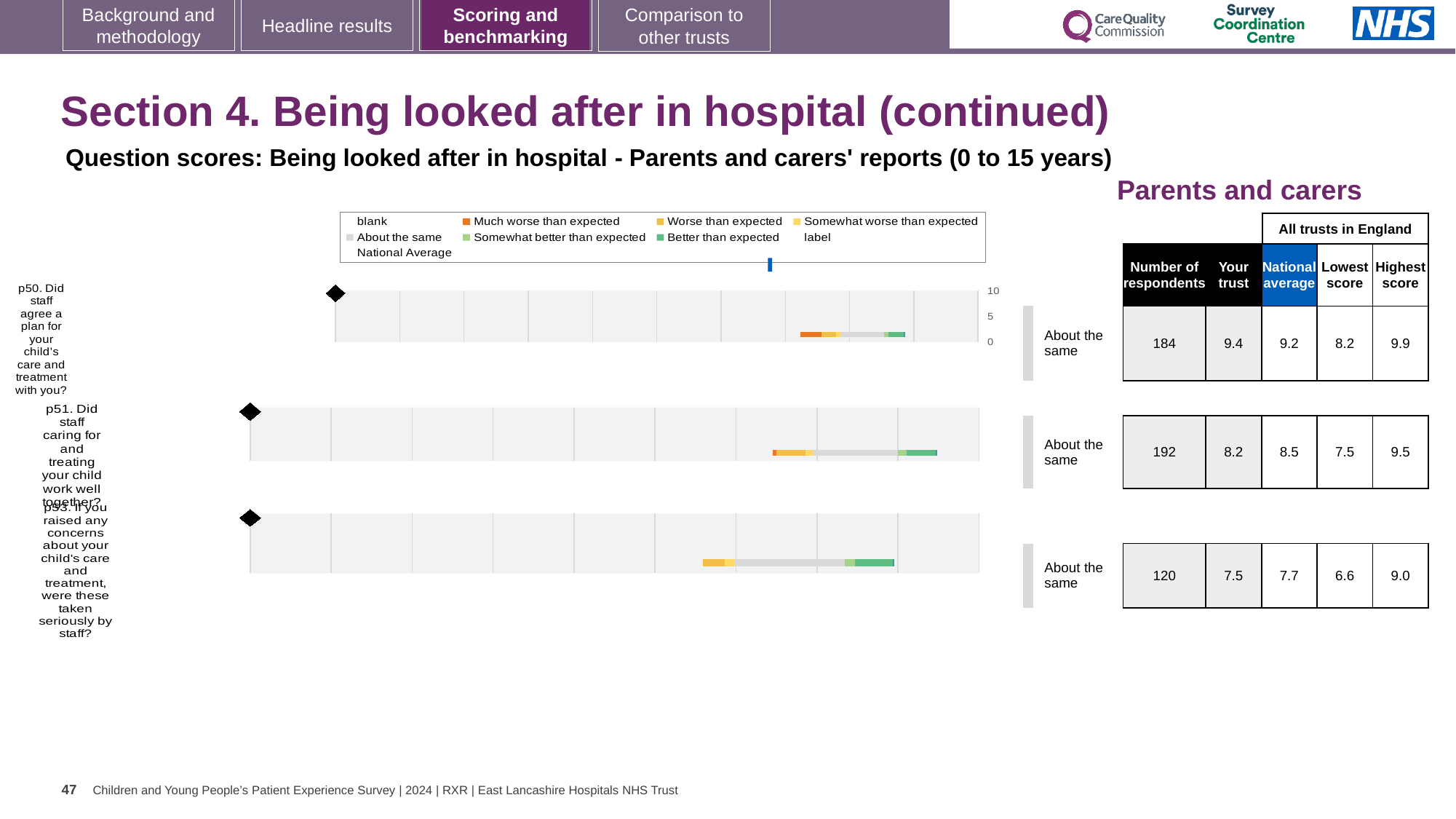
How many respondents are shown for p53 (If you raised any concerns about your child's care and treatment, were these taken seriously by staff?)? 120 For p50, which is larger: the 'Your trust' score or the national average? Your trust What is the difference between the national average and the 'Your trust' score for p51? 0.3 What is the difference between the highest score and the lowest score for p50? 1.7 What is the national average score for p51 (Did staff caring for and treating your child work well together?)? 8.5 What is the highest score across all trusts in England for p53? 9.0 How many questions are plotted on this slide? 3 Which question has the highest 'Your trust' score? p50 What kind of chart is used to show the question scores? Bar chart Which question has the lowest 'Your trust' score? p53 What benchmark category is shown for p51? About the same What is the 'Your trust' score for p50 (Did staff agree a plan for your child's care and treatment with you?)? 9.4